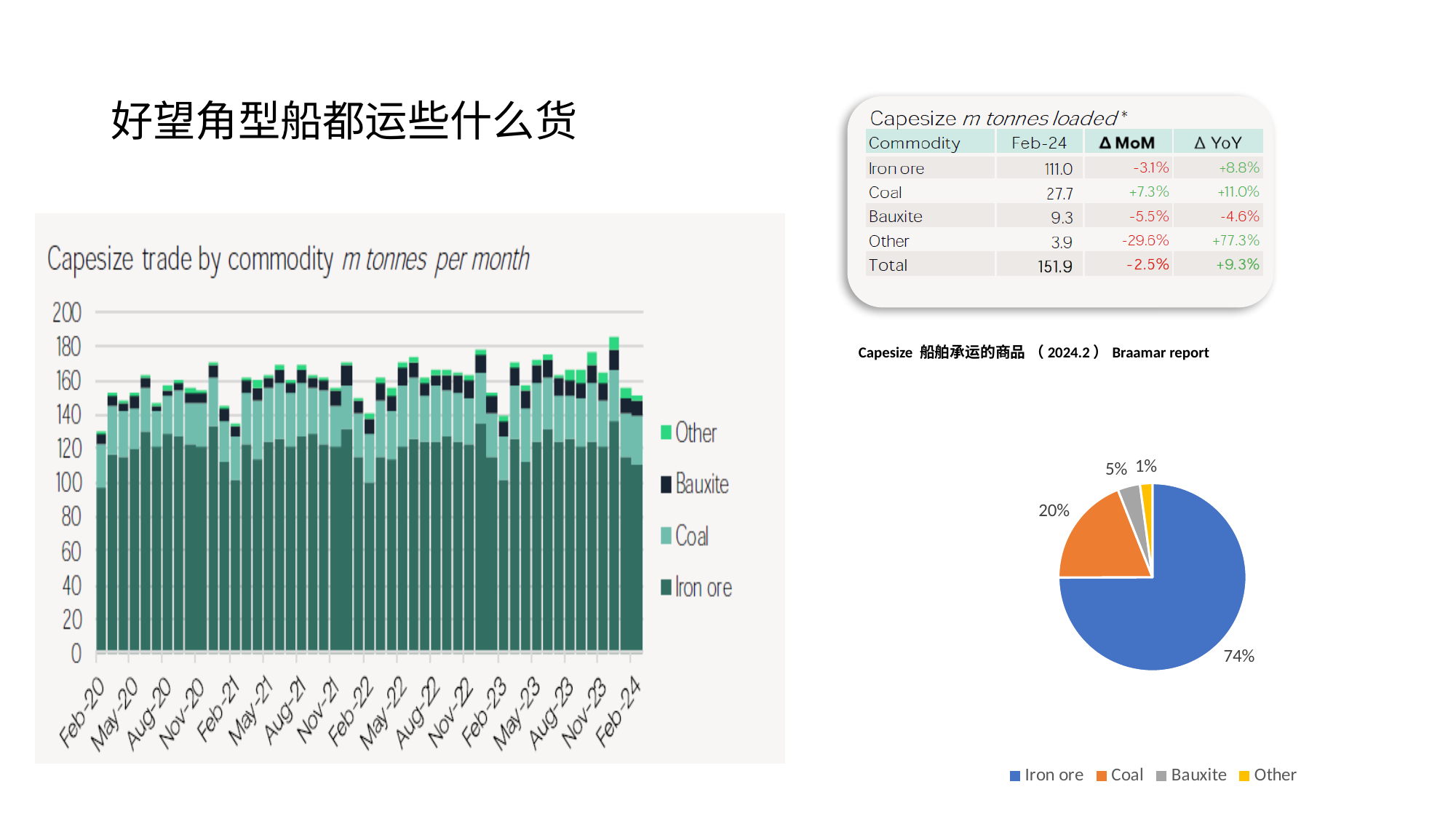
How many series does the legend of 'Capesize trade by commodity m tonnes per month' list? 4 What kind of chart is 'Capesize trade by commodity m tonnes per month'? bar chart In the pie chart at the bottom right, what share does Coal have? 20% In the pie chart at the bottom right, which category has the smallest slice? Other In the pie chart at the bottom right, how many percentage points larger is the Iron ore share than the Coal share? 54 In 'Capesize trade by commodity m tonnes per month', which series forms the largest part of each stacked bar? Iron ore In the pie chart at the bottom right, what share does Bauxite have? 5% In the pie chart at the bottom right, what share does Iron ore have? 74% In 'Capesize trade by commodity m tonnes per month', is the total for Feb-20 greater or less than 140? less In the pie chart at the bottom right, which category has the largest slice? Iron ore How many categories does the legend of the pie chart at the bottom right list? 4 What kind of chart is the chart at the bottom right of the slide? pie chart